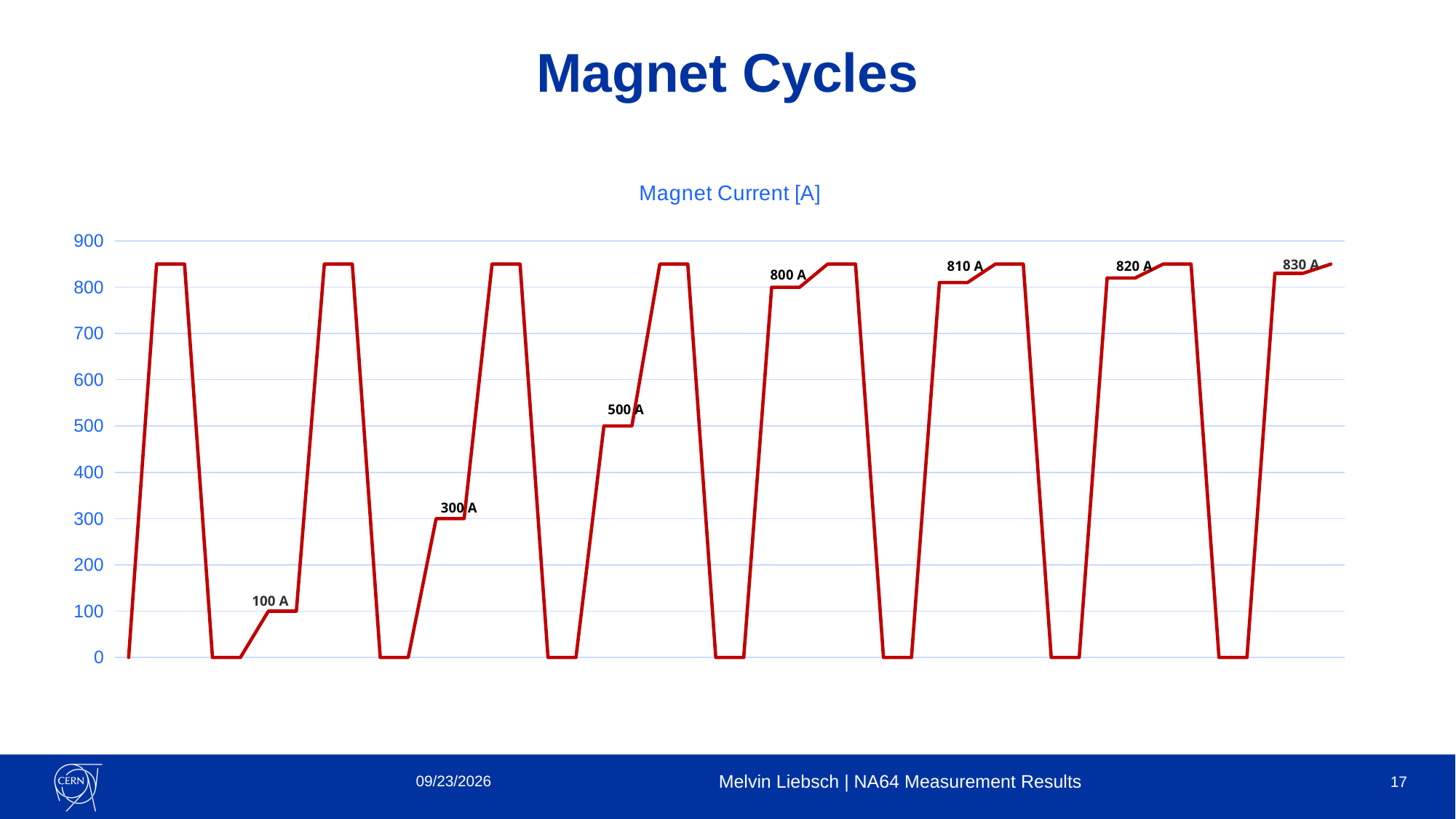
Which labeled plateau has the lowest value? 100 A Do the labeled intermediate plateau values rise or fall from left to right along the chart? rise What is the title of the chart? Magnet Current [A] What is the difference between the 500 A plateau and the 300 A plateau? 200 A What kind of chart is shown on the slide? line chart What is the value of the first labeled intermediate plateau on the left of the chart? 100 A Which is larger, the 810 A plateau or the 500 A plateau? 810 A What is the value of the labeled plateau that comes right after the 300 A plateau? 500 A Which labeled plateau has the highest value? 830 A What is the difference between the 830 A plateau and the 800 A plateau? 30 A Is the value of the top plateaus of each cycle greater or less than 800? greater How many labeled intermediate plateaus are marked on the chart? 7